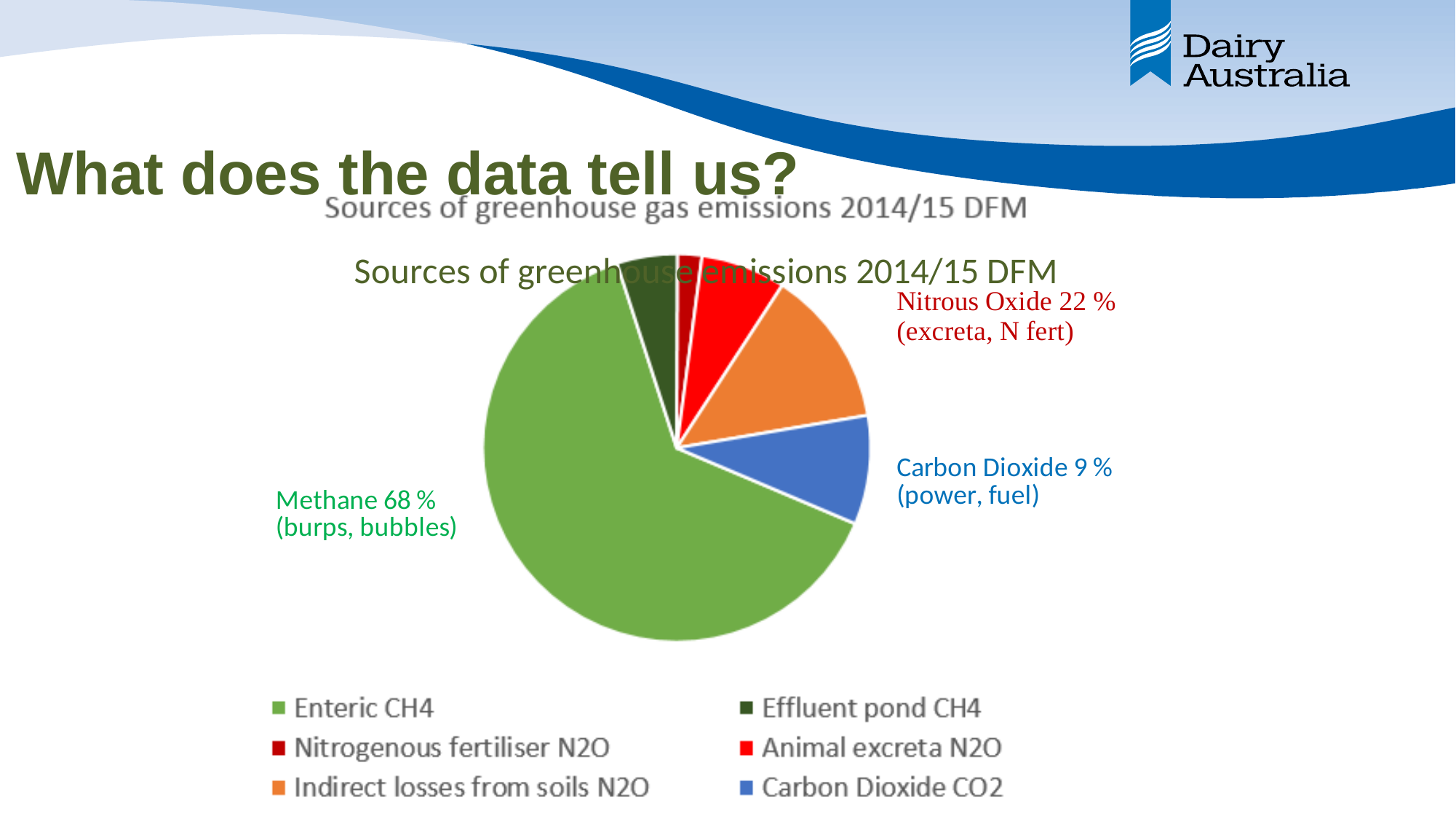
Which category has the largest slice of the pie chart? Enteric CH4 What kind of chart is shown on the slide? pie chart What colour is the Enteric CH4 slice in the pie chart? green What share of emissions is attributed to Carbon Dioxide according to the annotation on the chart? 9 % How many slices does the pie chart have? 6 Which slice is larger: Enteric CH4 or Carbon Dioxide CO2? Enteric CH4 What share of emissions is attributed to Nitrous Oxide according to the annotation on the chart? 22 % What share of emissions is attributed to Methane according to the annotation on the chart? 68 % Which slice is larger: Indirect losses from soils N2O or Animal excreta N2O? Indirect losses from soils N2O Which category has the smallest slice of the pie chart? Nitrogenous fertiliser N2O How many entries does the legend of the pie chart list? 6